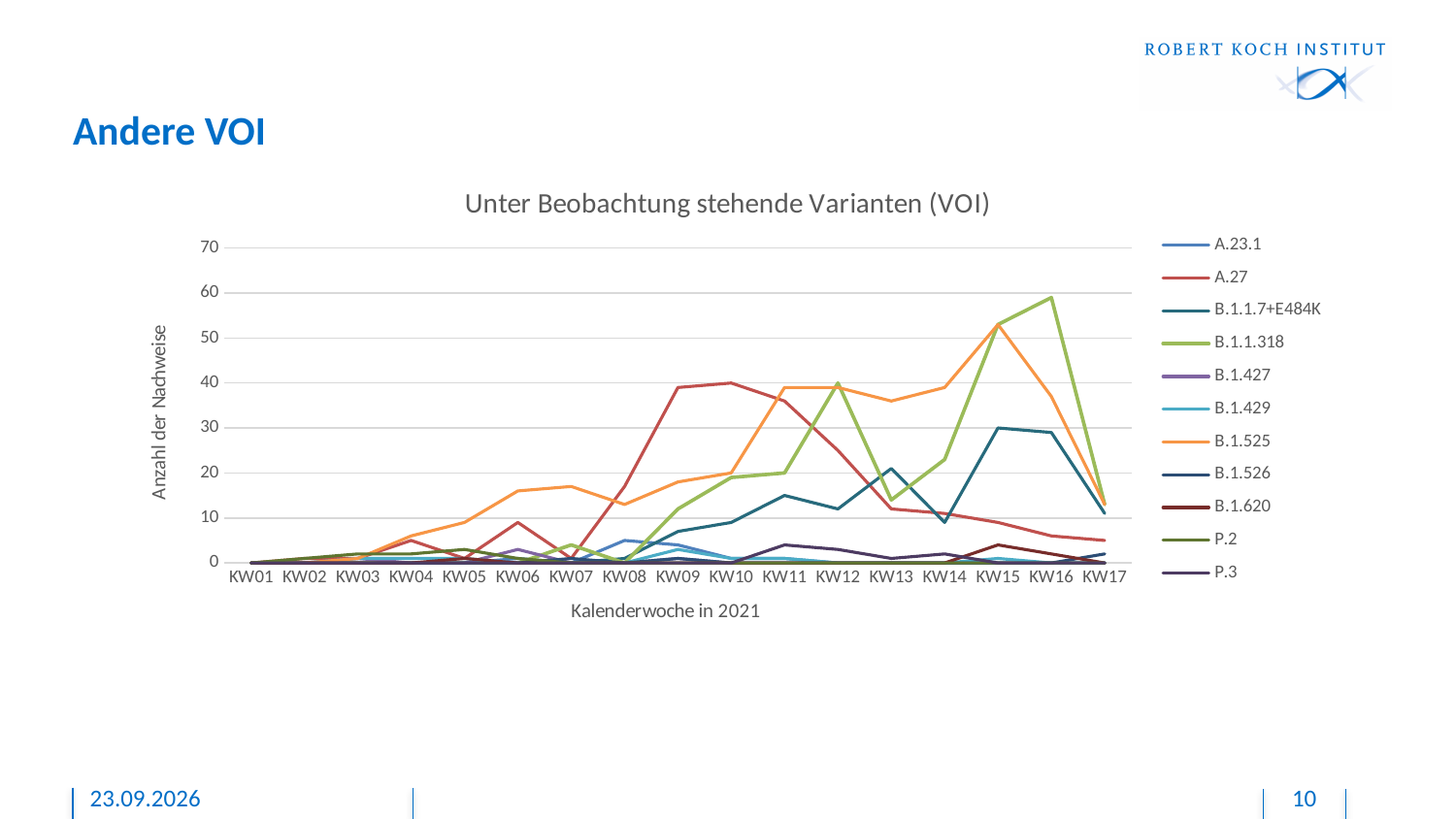
How many calendar weeks are shown on the x axis? 17 In KW16, which series has the larger value, B.1.1.318 or B.1.525? B.1.1.318 In which calendar week does B.1.525 reach its highest value? KW15 What is the title of the chart? Unter Beobachtung stehende Varianten (VOI) Is the value for B.1.526 in KW15 greater or less than 20? less What type of chart is shown on the slide? line chart In which calendar week does B.1.1.318 reach its highest value? KW16 How many series does the legend list? 11 Which series reaches the highest value anywhere in the chart? B.1.1.318 What is the label of the y axis? Anzahl der Nachweise Is the value for B.1.1.318 in KW16 greater or less than 50? greater Is the value for A.27 in KW09 greater or less than 30? greater